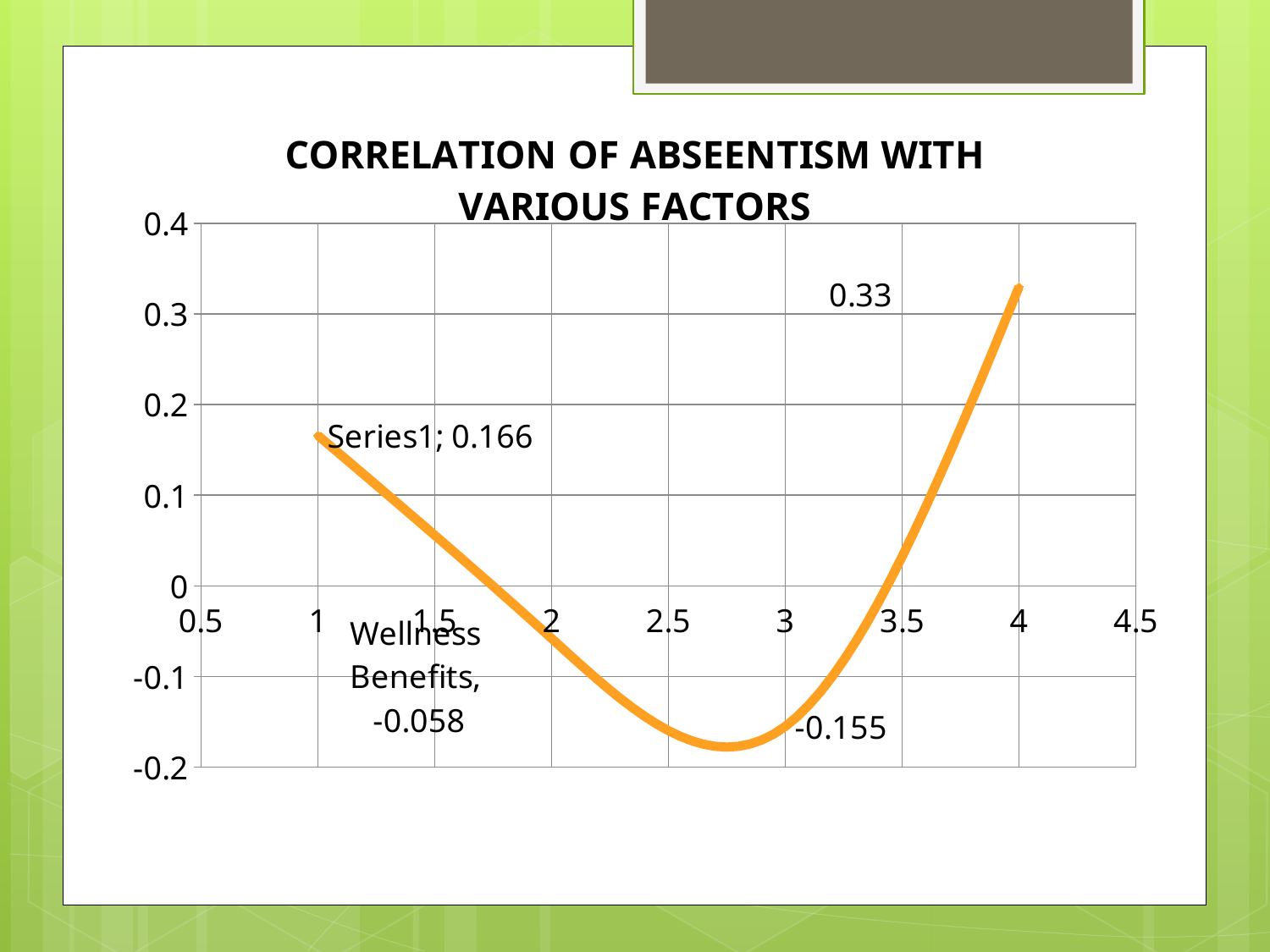
Which x position has the lowest plotted value? 3 What is the title of the chart? CORRELATION OF ABSEENTISM WITH VARIOUS FACTORS What is the value of the data point at x = 1? 0.166 What kind of chart is shown on the slide? line chart Which is larger, the value at x = 1 or the value for Wellness Benefits? the value at x = 1 Which x position has the highest plotted value? 4 What is the difference between the value at x = 4 and the value at x = 1? 0.164 What is the value labelled for Wellness Benefits? -0.058 How many data points are plotted on the line? 4 What is the value of the data point at x = 3? -0.155 What is the value of the data point at x = 4? 0.33 Is the value at x = 4 greater or less than 0.3? greater